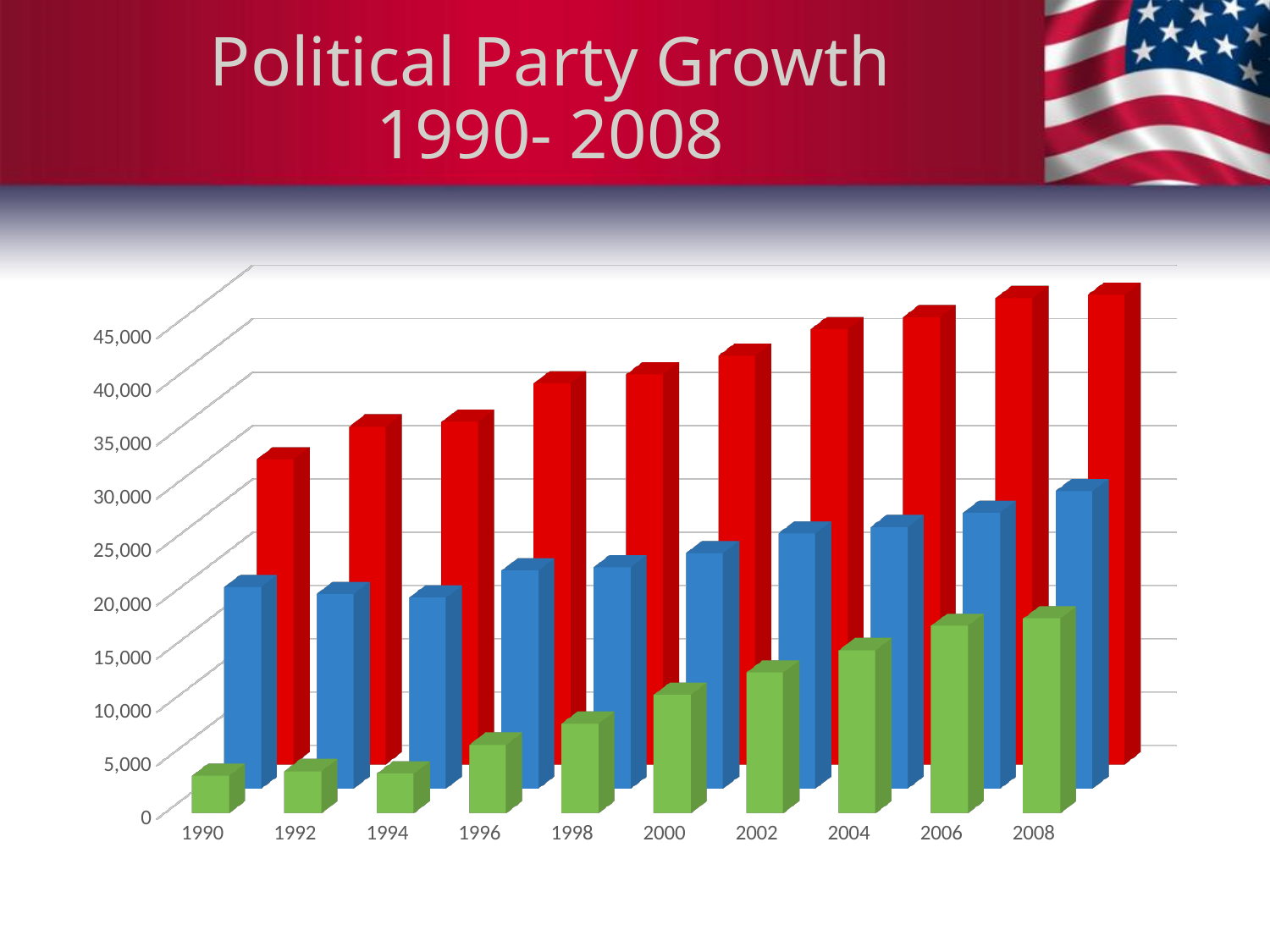
Is the value of the green bar for 2008 greater or less than 15,000? greater Is the value of the green bar for 1990 greater or less than 10,000? less Do the red bars rise or fall from 1990 to 2008? rise Which is larger in 2008, the red bar or the blue bar? the red bar What kind of chart is shown on the slide? bar chart Is the value of the blue bar for 2008 greater or less than 25,000? greater How many differently coloured bar series are plotted in the chart? 3 How many years are shown along the x axis of the chart? 10 What colours are the three bar series in the chart? red, blue and green What is the title of the slide containing the chart? Political Party Growth 1990- 2008